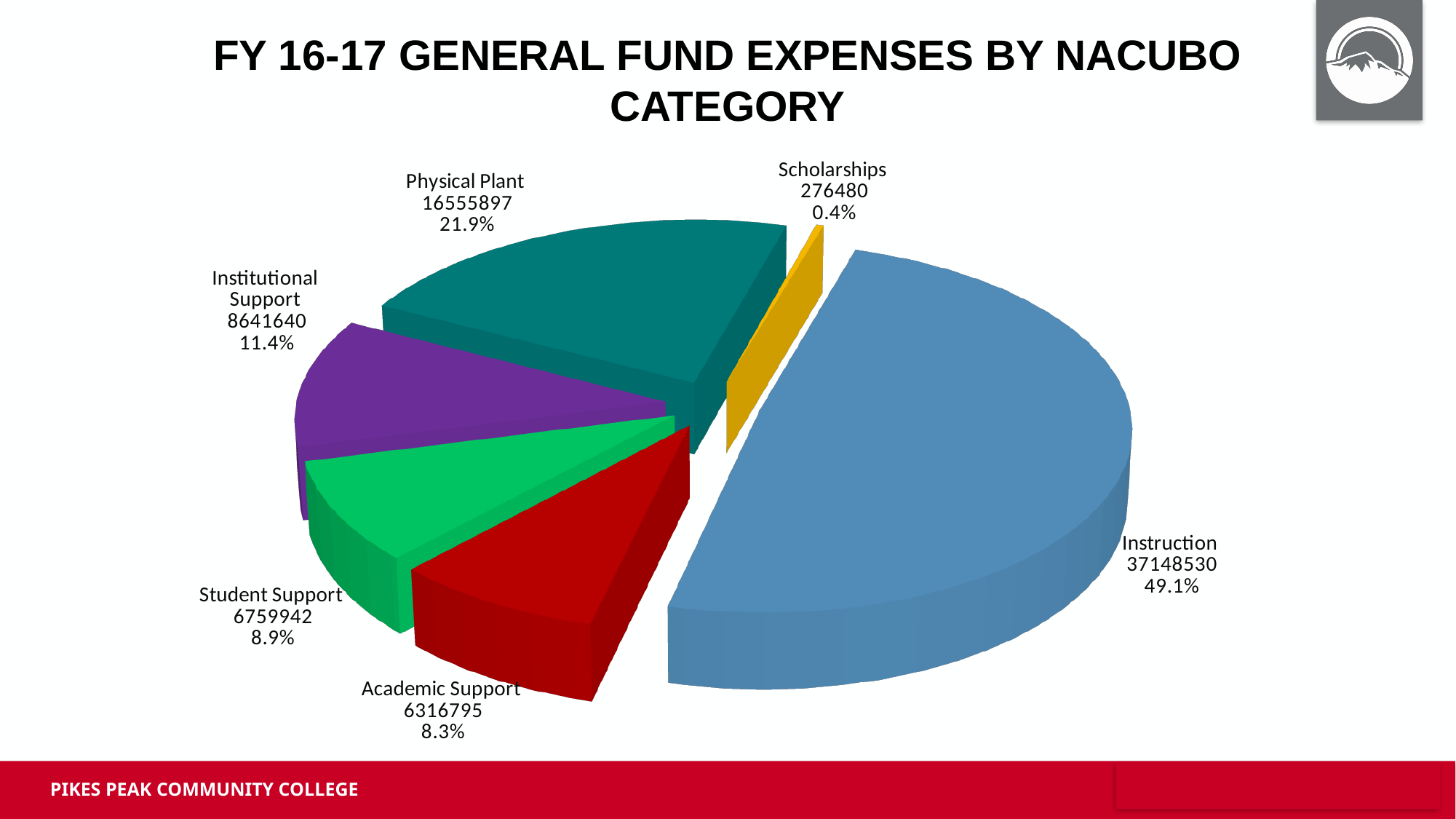
What is the difference between the values for Student Support and Academic Support? 443147 What kind of chart is shown on the slide? Pie chart How many categories are shown in the pie chart? 6 Which is larger, Institutional Support or Student Support? Institutional Support What is the value for Instruction? 37148530 What percentage share does Physical Plant have? 21.9% What is the value for Scholarships? 276480 Which category has the largest share of the pie? Instruction Which category has the smallest share of the pie? Scholarships What is the title of the chart? FY 16-17 GENERAL FUND EXPENSES BY NACUBO CATEGORY What percentage share does Institutional Support have? 11.4% What colour is the Instruction slice? Blue